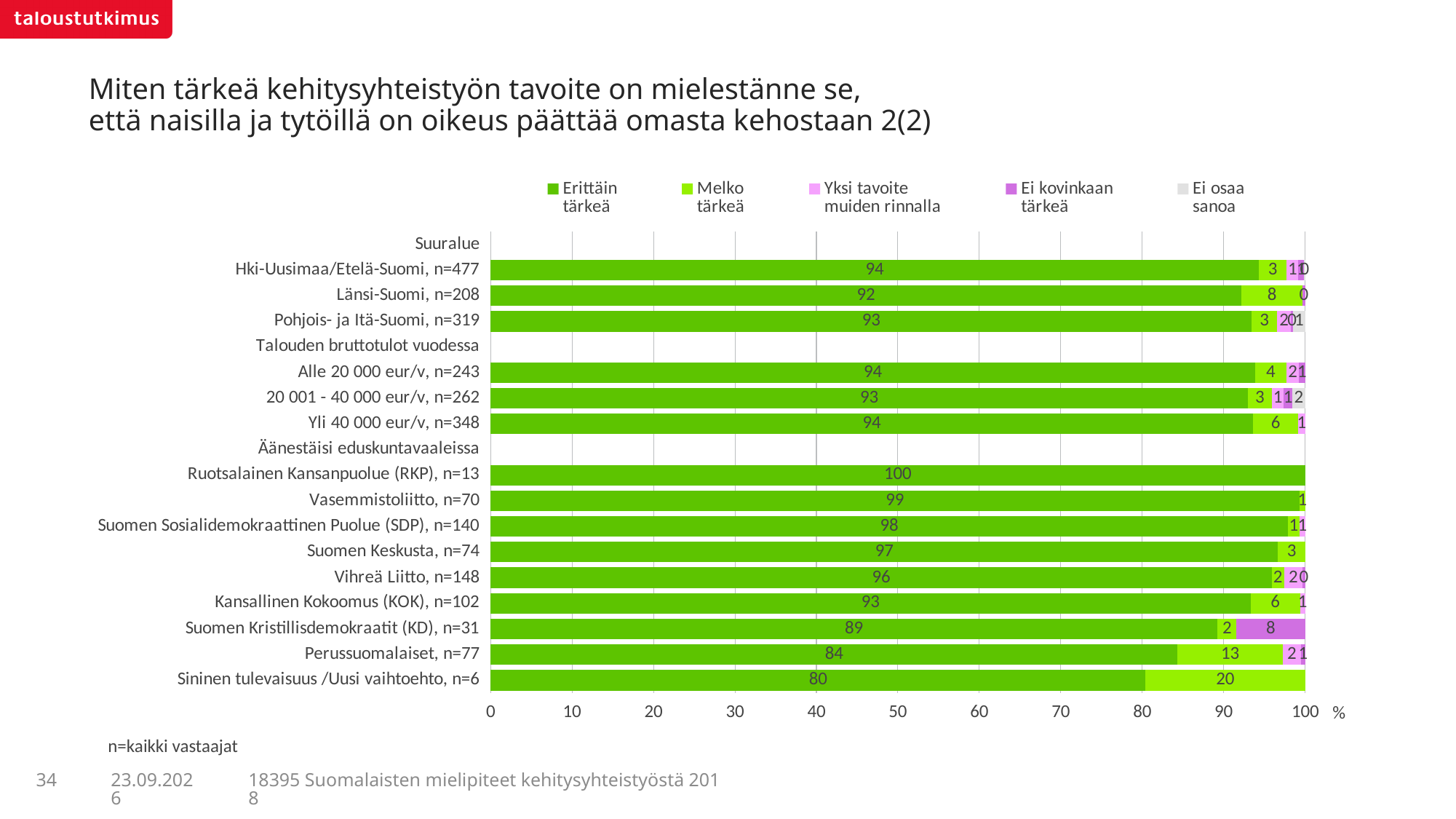
What kind of chart is shown on the slide? Stacked bar chart What is the difference in the "Erittäin tärkeä" value between Vasemmistoliitto and Perussuomalaiset? 15 What is the "Melko tärkeä" value for Sininen tulevaisuus /Uusi vaihtoehto, n=6? 20 Which group has the highest "Erittäin tärkeä" value? Ruotsalainen Kansanpuolue (RKP), n=13 Which has a larger "Erittäin tärkeä" value: Kansallinen Kokoomus (KOK) or Suomen Kristillisdemokraatit (KD)? Kansallinen Kokoomus (KOK) What is the "Melko tärkeä" value for Länsi-Suomi, n=208? 8 Which group has the lowest "Erittäin tärkeä" value? Sininen tulevaisuus /Uusi vaihtoehto, n=6 How many series does the legend list? 5 What percentage of Perussuomalaiset respondents (n=77) answered "Erittäin tärkeä"? 84 Is the "Erittäin tärkeä" value for Sininen tulevaisuus /Uusi vaihtoehto greater or less than 90? less What is the difference in the "Erittäin tärkeä" value between Hki-Uusimaa/Etelä-Suomi and Länsi-Suomi? 2 What is the "Ei kovinkaan tärkeä" value for Suomen Kristillisdemokraatit (KD), n=31? 8